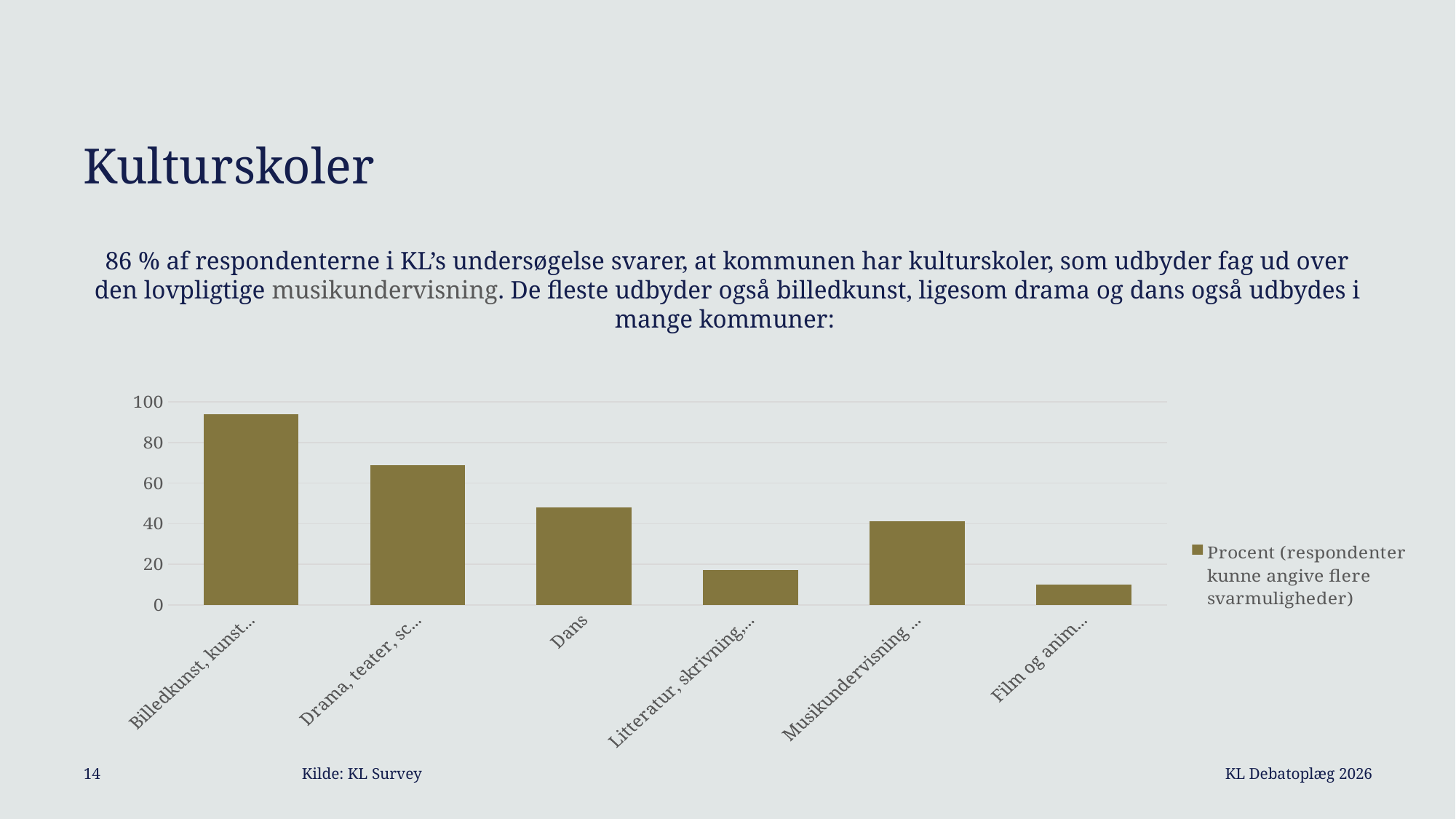
Which category has the highest bar in the chart? Billedkunst, kunst... What is the legend entry shown for the series in the chart? Procent (respondenter kunne angive flere svarmuligheder) How many series does the chart's legend list? 1 Which is larger, the value for Drama, teater, sc... or the value for Dans? Drama, teater, sc... What kind of chart is shown on the slide? bar chart Is the value for Drama, teater, sc... greater or less than 60? greater Which category has the lowest bar in the chart? Film og anim... Which is larger, the value for Musikundervisning ... or the value for Film og anim...? Musikundervisning ... Is the value for Dans greater or less than 40? greater How many categories are plotted on the x axis of the chart? 6 Is the value for Billedkunst, kunst... greater or less than 80? greater